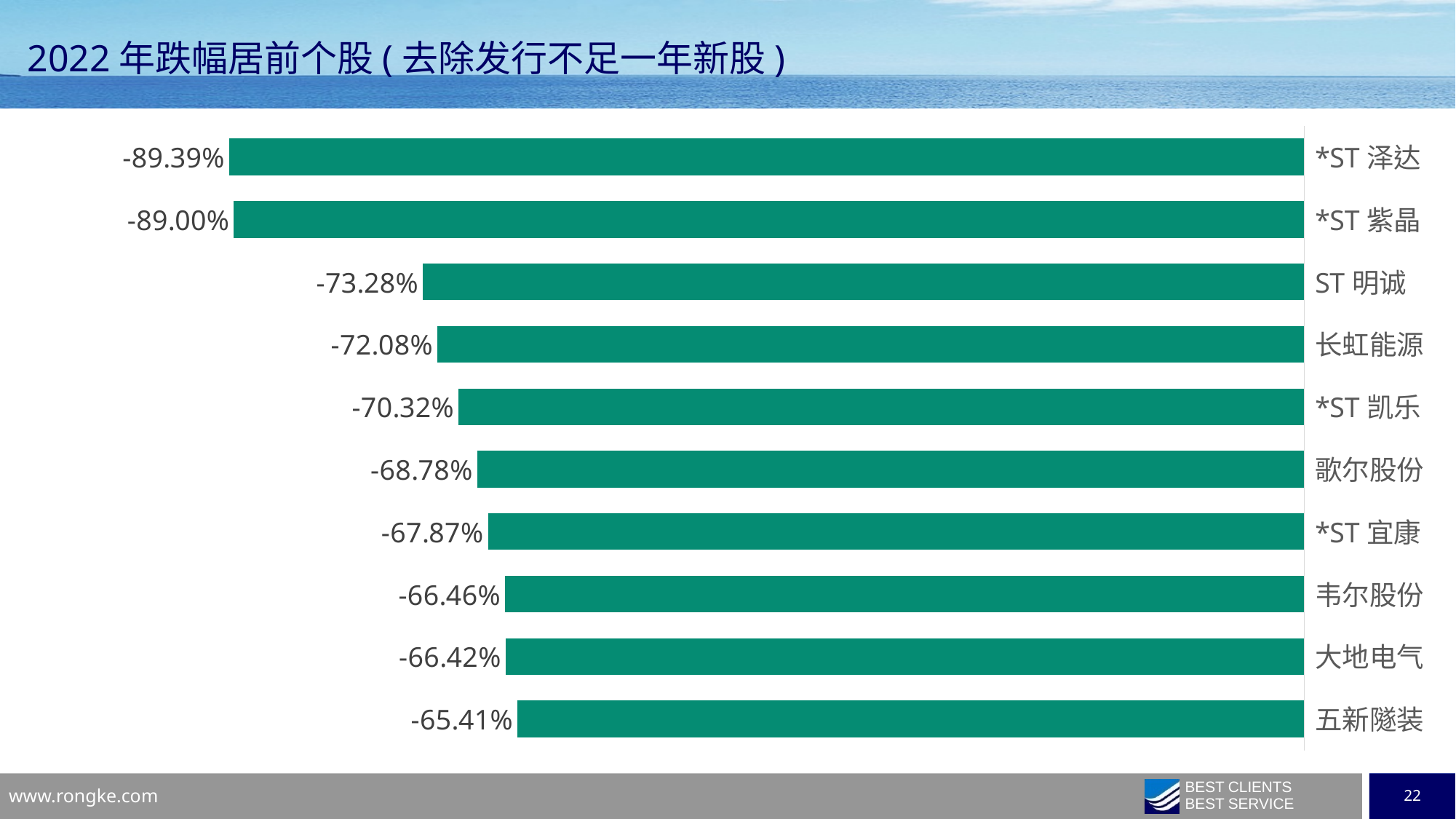
What is the difference between the values for *ST 泽达 and *ST 紫晶? 0.39% Which stock fell more, *ST 凯乐 or 韦尔股份? *ST 凯乐 Which stock has the smallest decline (highest value) on the chart? 五新隧装 What is the value shown for 五新隧装? -65.41% What is the title of the chart? 2022 年跌幅居前个股 ( 去除发行不足一年新股 ) What is the value shown for 歌尔股份? -68.78% Which stock has the largest decline (lowest value) on the chart? *ST 泽达 What is the value shown for *ST 泽达? -89.39% What is the value shown for 长虹能源? -72.08% What kind of chart is shown on the slide? Bar chart What is the difference between the values for ST 明诚 and 五新隧装? 7.87% How many stocks are shown on the chart? 10